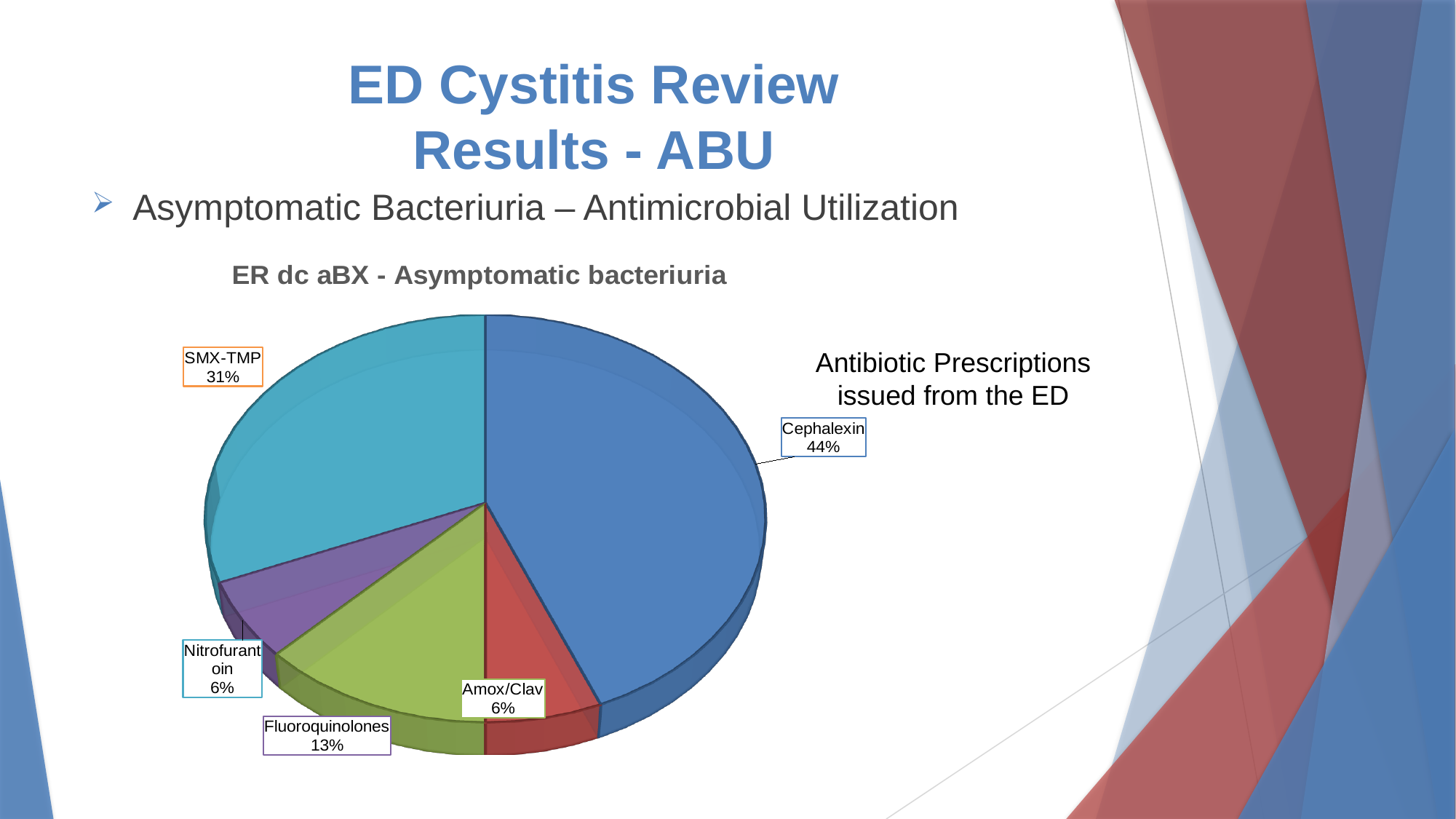
What is the difference in percentage points between Cephalexin and SMX-TMP? 13 Which antibiotic has the largest slice of the pie? Cephalexin What is the title of the chart? ER dc aBX - Asymptomatic bacteriuria How many slices does the pie chart have? 5 Which is larger, the share for SMX-TMP or the share for Fluoroquinolones? SMX-TMP What percentage is shown for Nitrofurantoin? 6% What percentage is shown for Fluoroquinolones? 13% What share of the pie does SMX-TMP represent? 31% What share of the pie does Cephalexin represent? 44% What percentage is shown for Amox/Clav? 6% What is the difference in percentage points between Fluoroquinolones and Amox/Clav? 7 What type of chart is shown on the slide? Pie chart